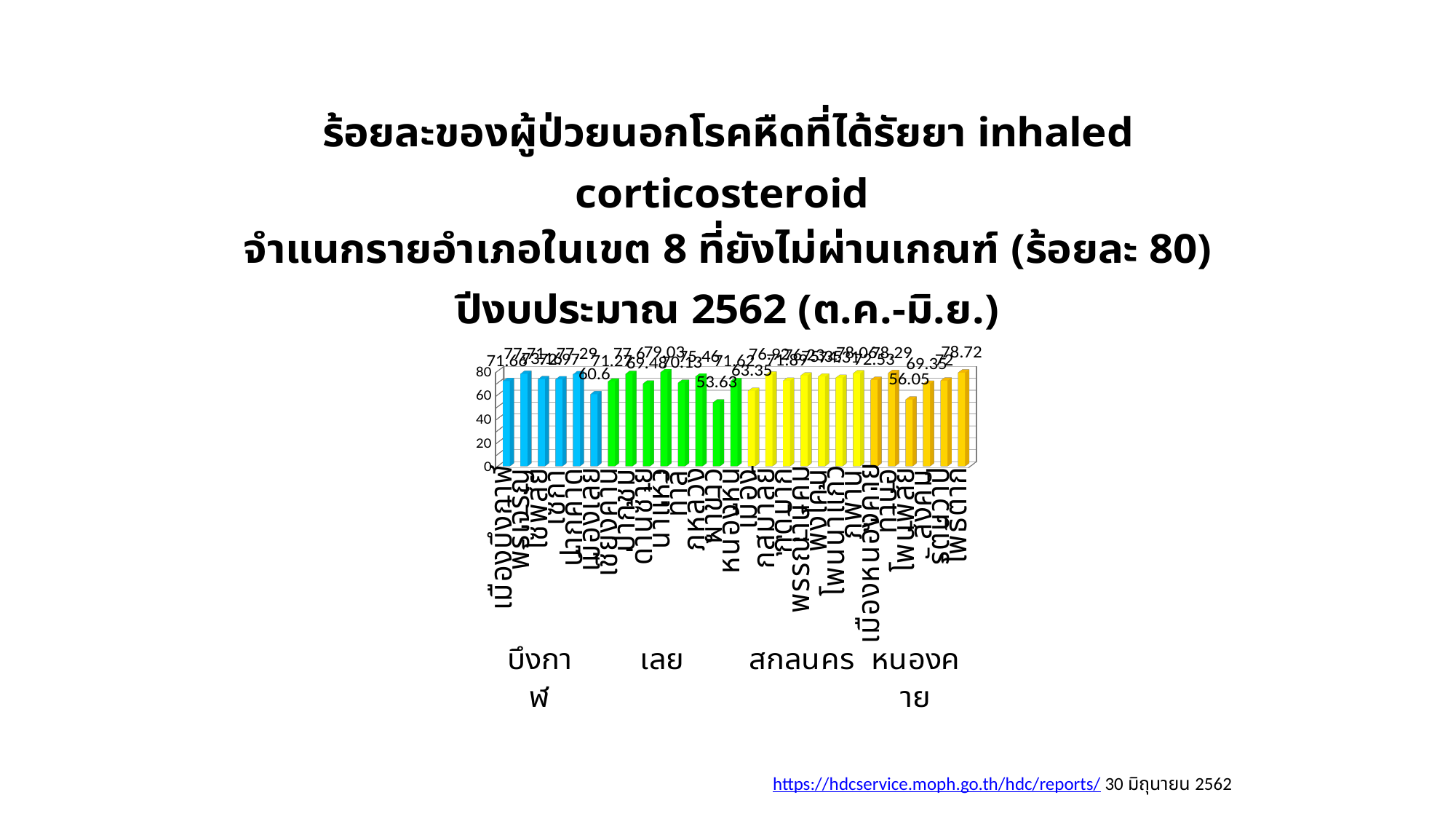
Which province group contains the bar with the lowest value (53.63)? เลย How many province groups are labelled along the bottom of the chart? 4 Is the lowest bar in the หนองคาย group greater or less than 60? less Is the bar labelled 53.63 greater or less than 60? less What colour are the bars for the บึงกาฬ group? blue Which is larger, the bar labelled 60.6 in the บึงกาฬ group or the bar labelled 56.05 in the หนองคาย group? 60.6 What is the difference between the bar labelled 63.35 and the bar labelled 53.63? 9.72 What is the lowest value labelled on any bar in the chart? 53.63 What kind of chart is shown on the slide? bar chart What is the highest tick value shown on the vertical axis? 80